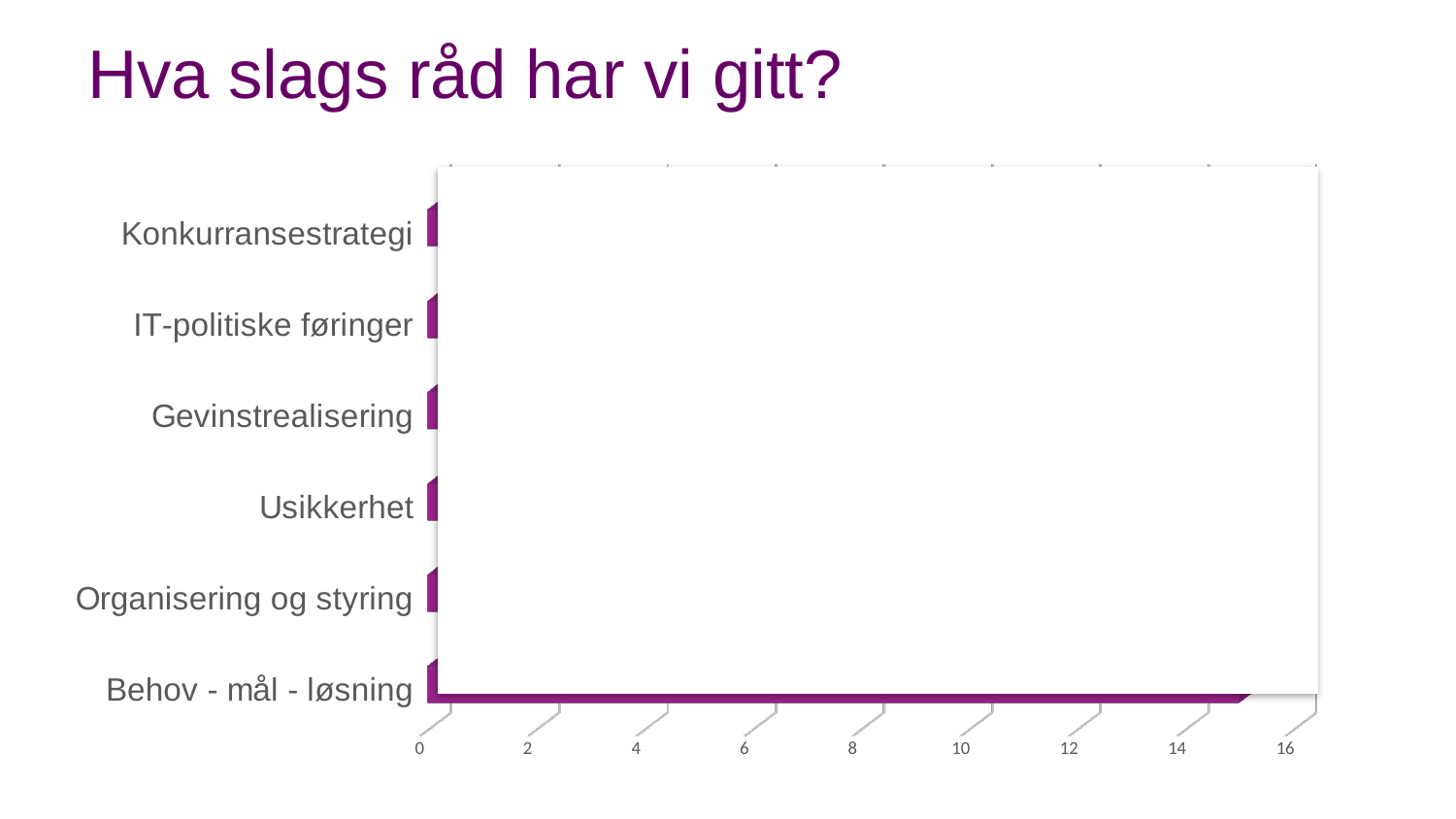
What is the title of the slide containing the chart? Hva slags råd har vi gitt? Which category is listed at the bottom of the chart's vertical axis? Behov - mål - løsning What kind of chart is shown on the slide? bar chart Is the value for Behov - mål - løsning greater or less than 16? less Is the value for Behov - mål - løsning greater or less than 14? greater Is the value for Behov - mål - løsning greater or less than 10? greater What is the highest value shown on the horizontal axis of the chart? 16 How many categories are listed on the vertical axis of the chart? 6